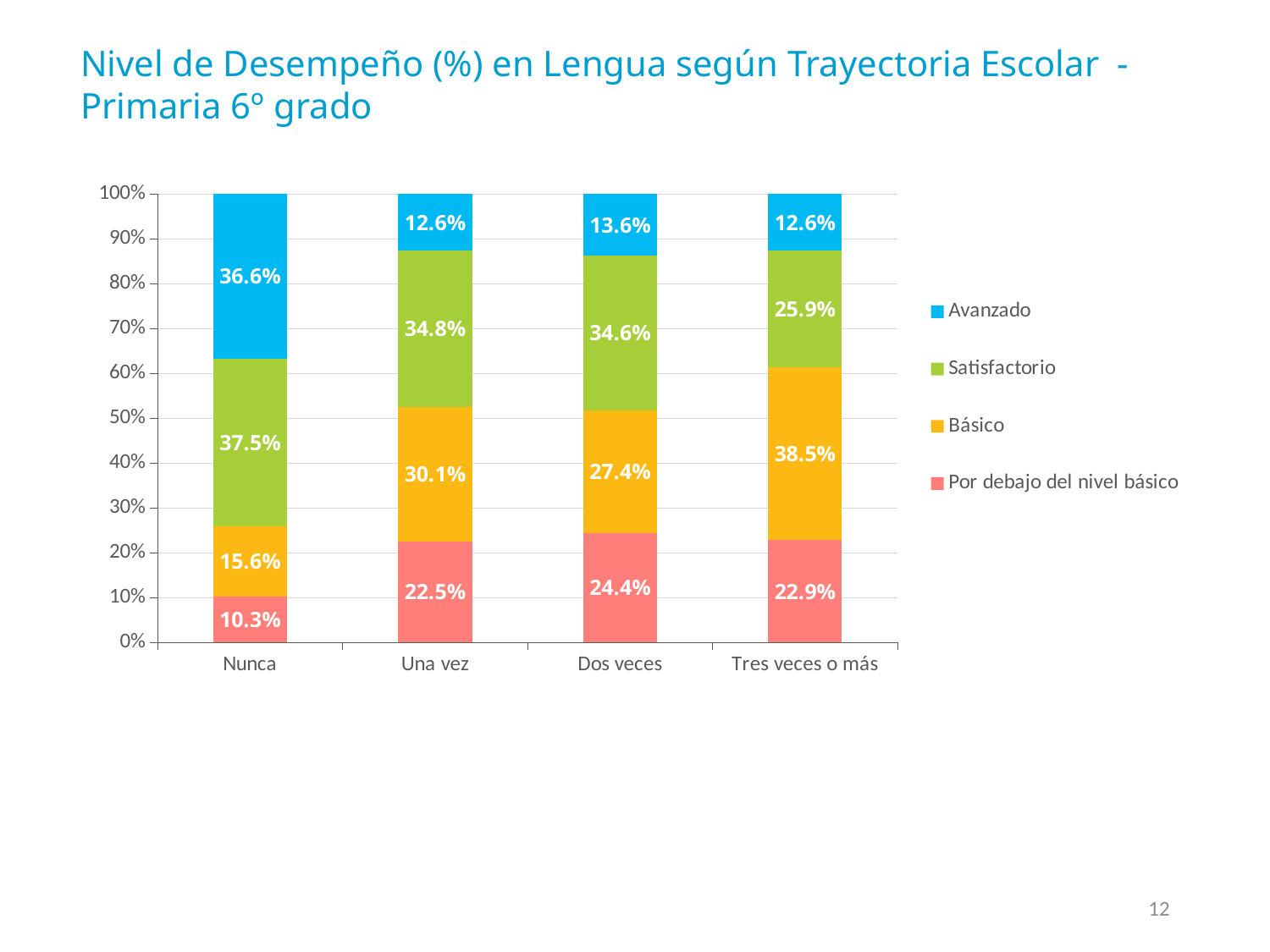
Which category has the lowest Por debajo del nivel básico value? Nunca What is the title of the chart on the slide? Nivel de Desempeño (%) en Lengua según Trayectoria Escolar - Primaria 6º grado What is the Avanzado value for Nunca? 36.6% Which is larger, the Básico value for Una vez or for Dos veces? Una vez What is the Por debajo del nivel básico value for Dos veces? 24.4% How many categories are shown on the x axis? 4 Which category has the highest Avanzado value? Nunca What type of chart is shown on the slide? Stacked bar chart What is the Satisfactorio value for Una vez? 34.8% How many series does the legend list? 4 What is the Básico value for Tres veces o más? 38.5% What is the difference between the Avanzado values for Nunca and Una vez? 24.0 percentage points